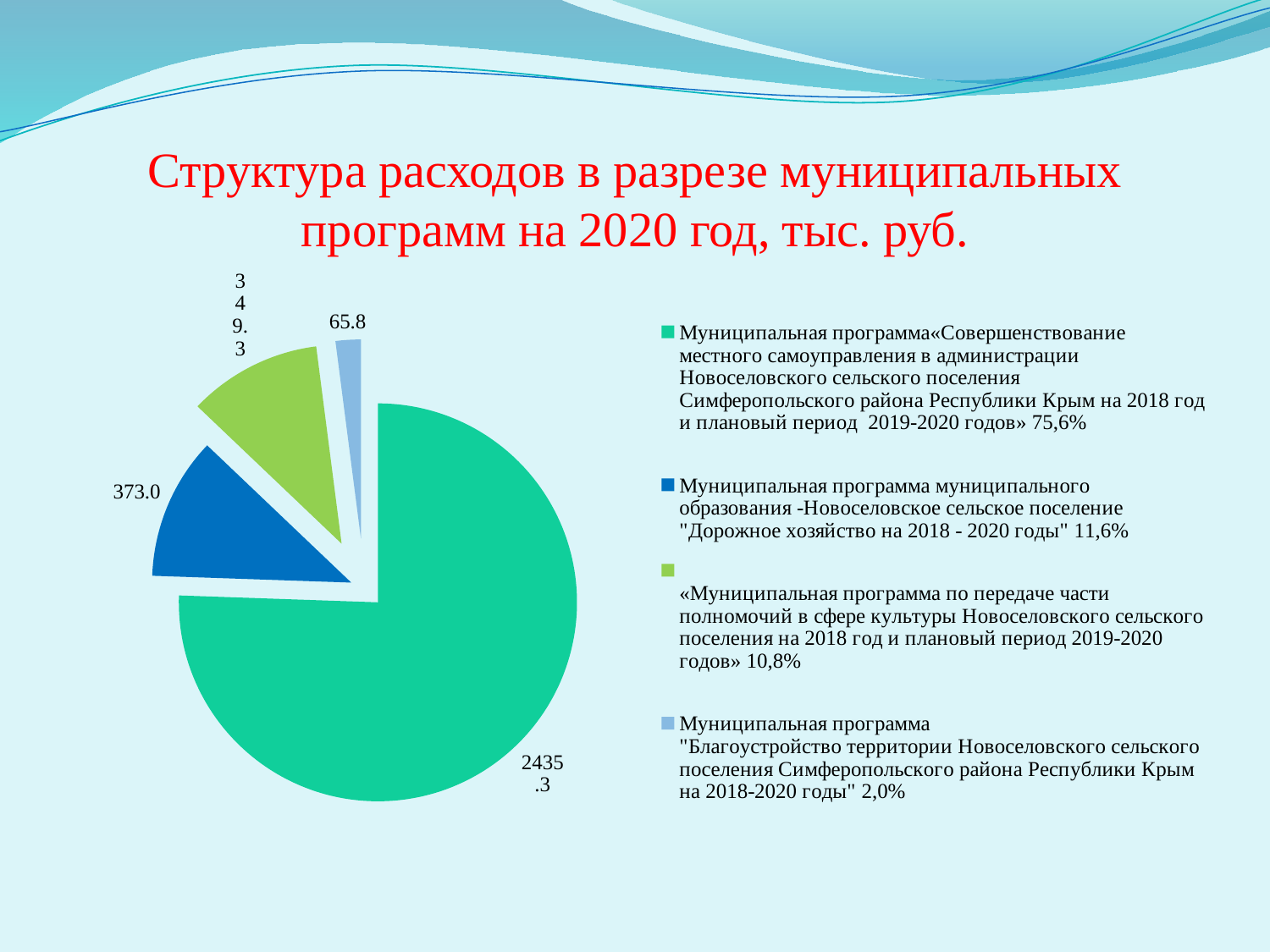
Which is larger: the slice for "Дорожное хозяйство" (373.0) or the slice for "Благоустройство территории" (65.8)? Дорожное хозяйство (373.0) What share of expenditures does the program "Совершенствование местного самоуправления" account for, according to the legend? 75,6% How many slices does the pie chart have? 4 How many entries does the legend list? 4 What kind of chart is shown on the slide? pie chart What is the difference between the largest slice (2435.3) and the "Дорожное хозяйство" slice (373.0)? 2062.3 What is the value of the largest slice of the pie chart? 2435.3 What is the title of the chart on the slide? Структура расходов в разрезе муниципальных программ на 2020 год, тыс. руб. What share of expenditures does the program "Благоустройство территории" account for, according to the legend? 2,0% What is the value of the smallest slice of the pie chart? 65.8 What value is shown for the light green slice, the program on transferring powers in the sphere of culture? 349.3 What value is shown for the blue slice, the program "Дорожное хозяйство на 2018 - 2020 годы"? 373.0